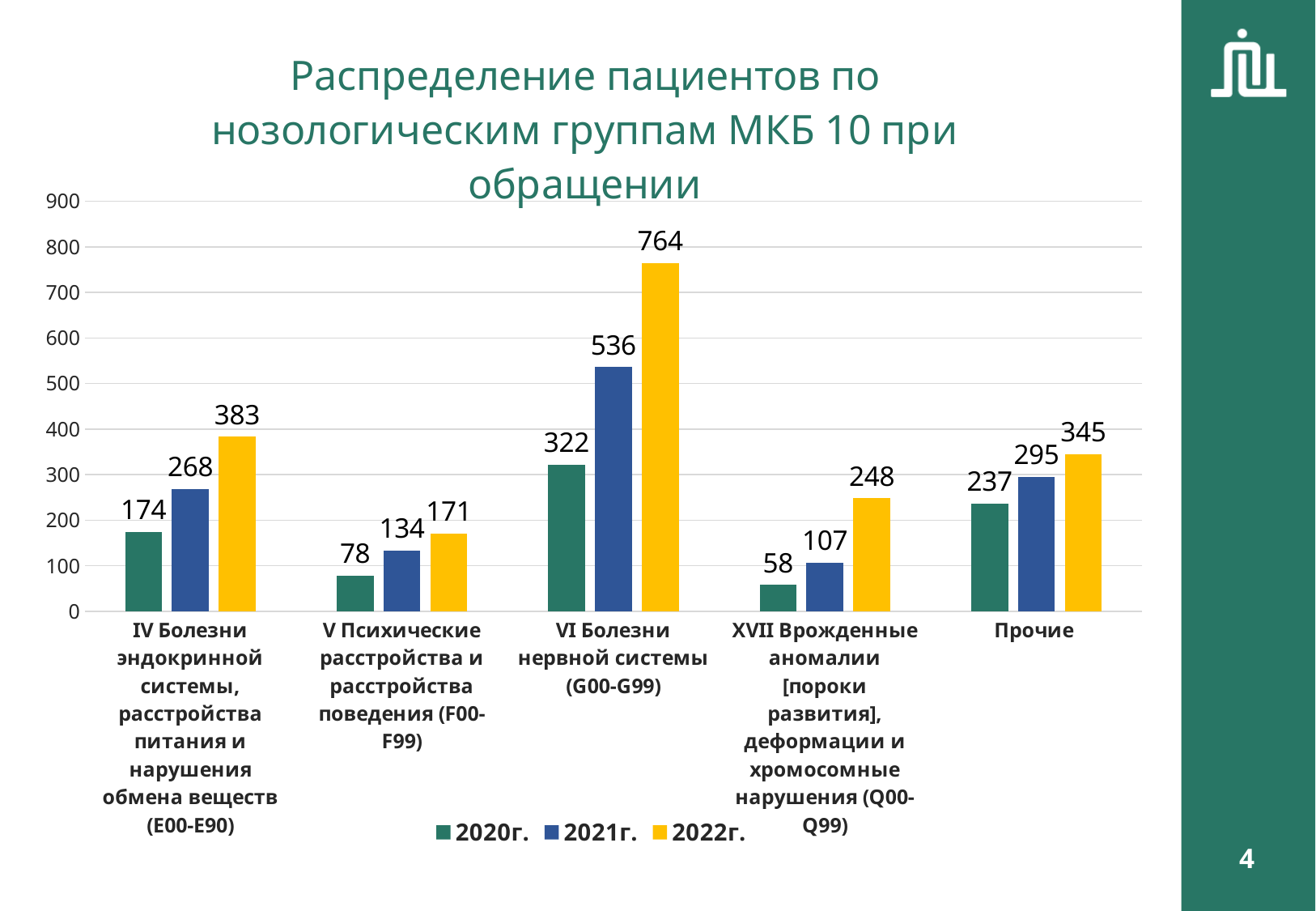
What is the value for 2020г. in the XVII Врожденные аномалии (Q00-Q99) category? 58 What is the difference between the 2022г. and 2020г. values in the IV Болезни эндокринной системы (E00-E90) category? 209 What kind of chart is shown on the slide? Bar chart Which colour represents the 2022г. series in the legend? Yellow Which is larger: the 2021г. value for V Психические расстройства (F00-F99) or the 2021г. value for XVII Врожденные аномалии (Q00-Q99)? V Психические расстройства (F00-F99) Within the Прочие category, do the values rise or fall from 2020г. to 2022г.? Rise What is the value for 2021г. in the Прочие category? 295 Which category has the highest value for 2022г.? VI Болезни нервной системы (G00-G99) Which category has the lowest value for 2020г.? XVII Врожденные аномалии (Q00-Q99) How many series does the legend list? 3 What is the value for 2022г. in the VI Болезни нервной системы (G00-G99) category? 764 How many categories are shown on the x axis? 5